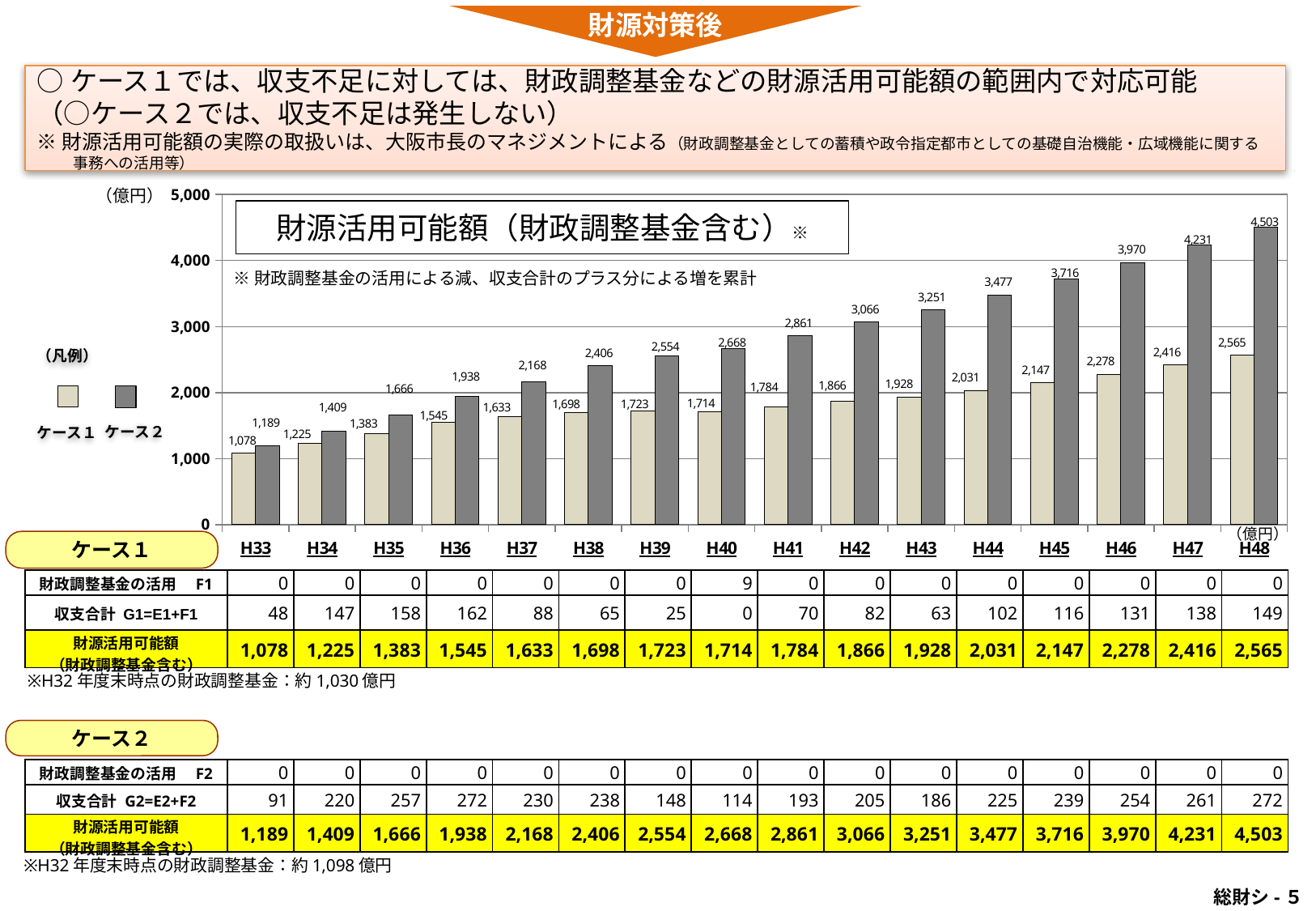
What is the difference between ケース２ and ケース１ in H48? 1,938 Which is larger in H45: ケース１ or ケース２? ケース２ What is the value for ケース２ in H41? 2,861 Do the values for ケース２ rise or fall from H33 to H48? Rise What kind of chart is shown? Bar chart What is the value for ケース２ in H48? 4,503 What is the value for ケース１ in H40? 1,714 Which year has the lowest value for ケース１? H33 How many series does the legend list? 2 Which year has the highest value for ケース２? H48 What is the value for ケース１ in H33? 1,078 How many years are shown on the x axis? 16